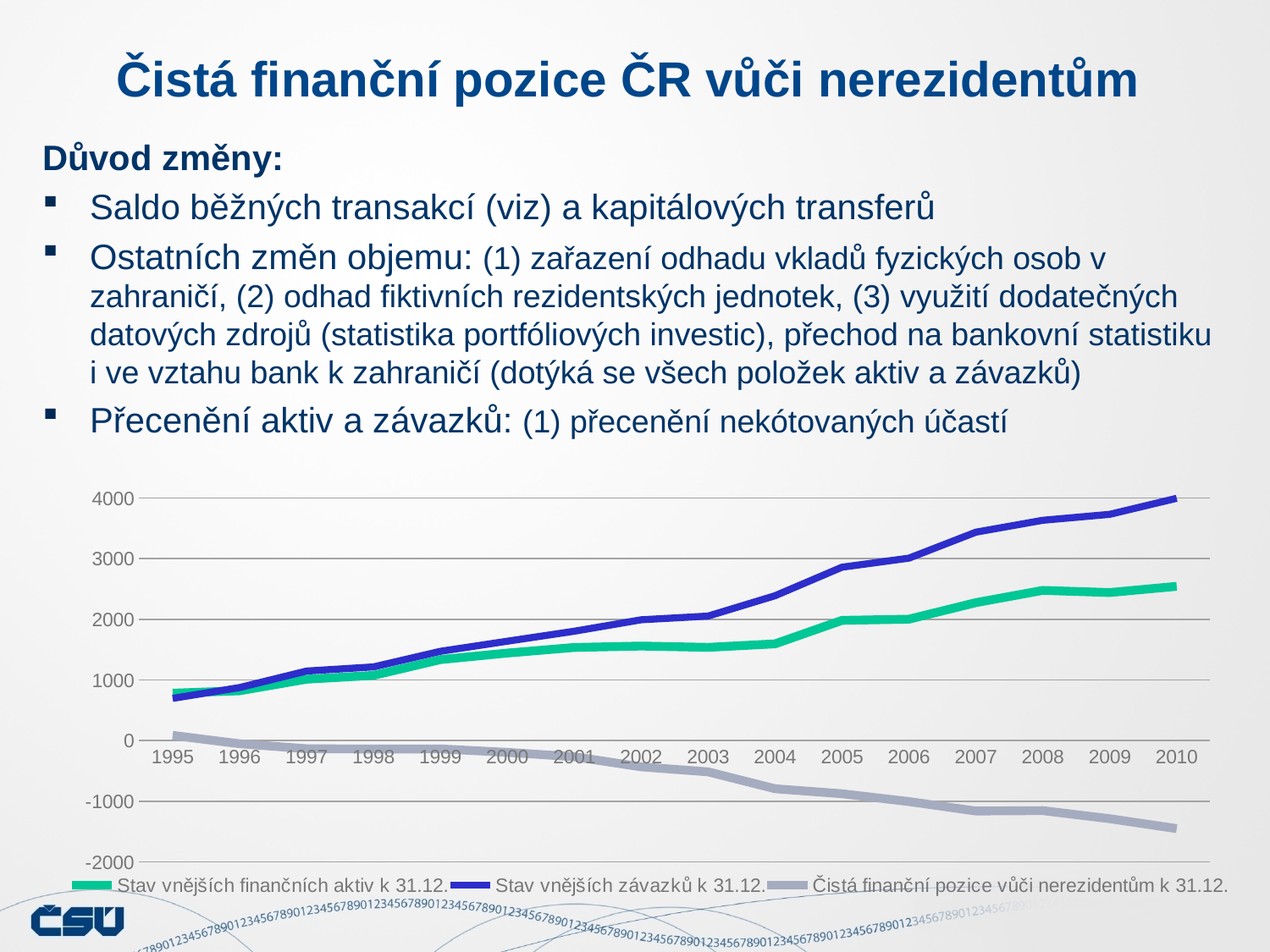
Is the value for 'Stav vnějších finančních aktiv k 31.12.' in 2010 greater or less than 2000? greater In 2010, which is larger: 'Stav vnějších závazků k 31.12.' or 'Stav vnějších finančních aktiv k 31.12.'? Stav vnějších závazků k 31.12. What kind of chart is shown on the slide? line chart How many series does the chart legend list? 3 Is the value for 'Stav vnějších závazků k 31.12.' in 2007 greater or less than 3000? greater Is the value for 'Stav vnějších závazků k 31.12.' in 2005 greater or less than 2000? greater In which year is 'Čistá finanční pozice vůči nerezidentům k 31.12.' at its lowest? 2010 Does the series 'Čistá finanční pozice vůči nerezidentům k 31.12.' rise or fall from 1995 to 2010? fall How many years are plotted along the x axis of the chart? 16 What colour is the line for 'Čistá finanční pozice vůči nerezidentům k 31.12.'? grey Does the series 'Stav vnějších závazků k 31.12.' rise or fall from 1995 to 2010? rise